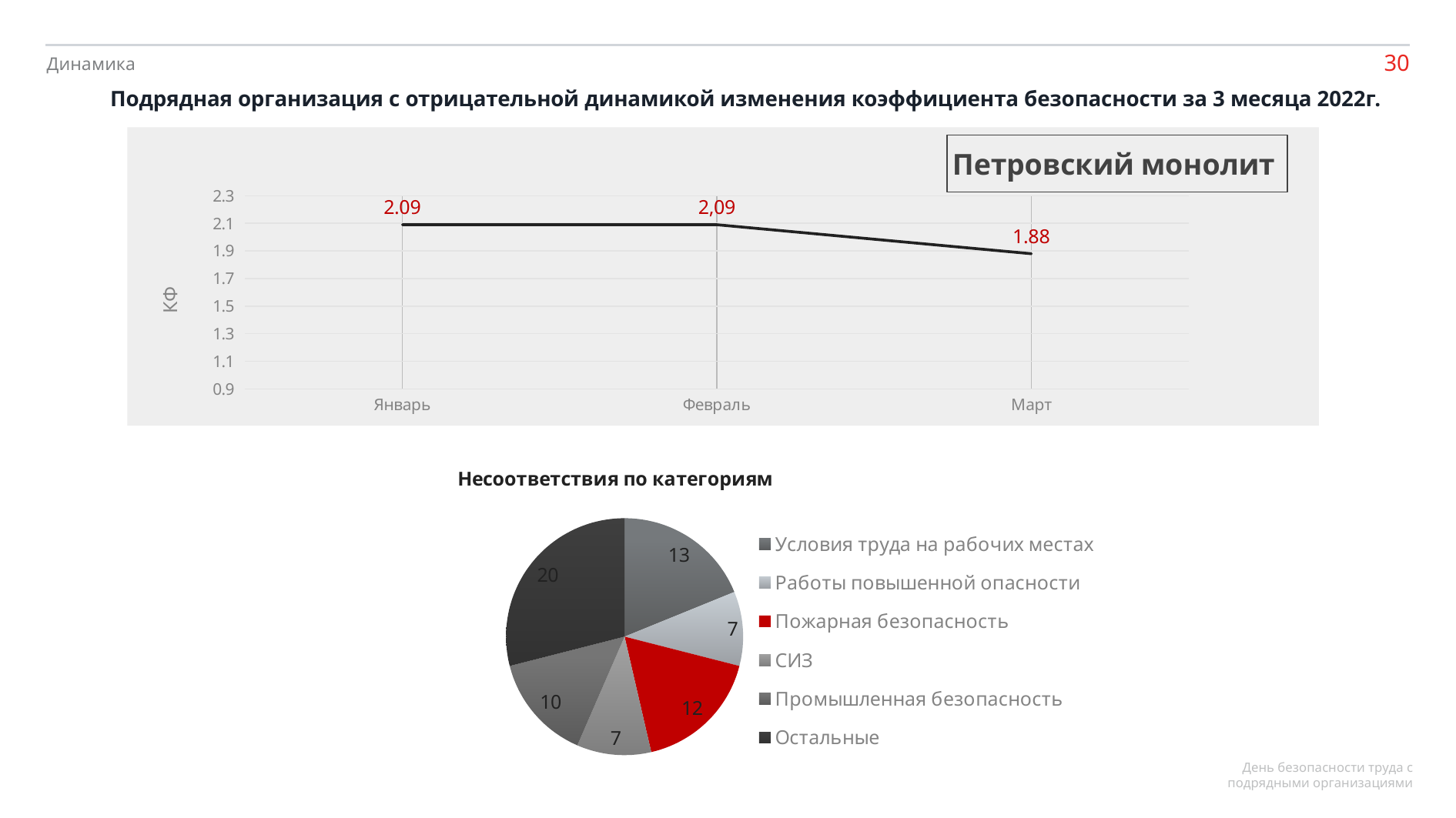
In the pie chart titled "Несоответствия по категориям", what is the value for Пожарная безопасность? 12 In the line chart titled "Петровский монолит", what is the difference between the values for Февраль and Март? 0.21 In the pie chart titled "Несоответствия по категориям", which is larger: Условия труда на рабочих местах or Промышленная безопасность? Условия труда на рабочих местах In the pie chart titled "Несоответствия по категориям", what is the difference between Остальные and СИЗ? 13 In the pie chart titled "Несоответствия по категориям", which category is shown in red? Пожарная безопасность In the pie chart titled "Несоответствия по категориям", how many categories does the legend list? 6 In the line chart titled "Петровский монолит", how many months are plotted on the x axis? 3 In the line chart titled "Петровский монолит", do the values rise or fall from Февраль to Март? fall In the line chart titled "Петровский монолит", what is the value for Январь? 2.09 In the pie chart titled "Несоответствия по категориям", which category has the largest slice? Остальные In the line chart titled "Петровский монолит", which month has the lowest value? Март In the line chart titled "Петровский монолит", what is the value for Март? 1.88